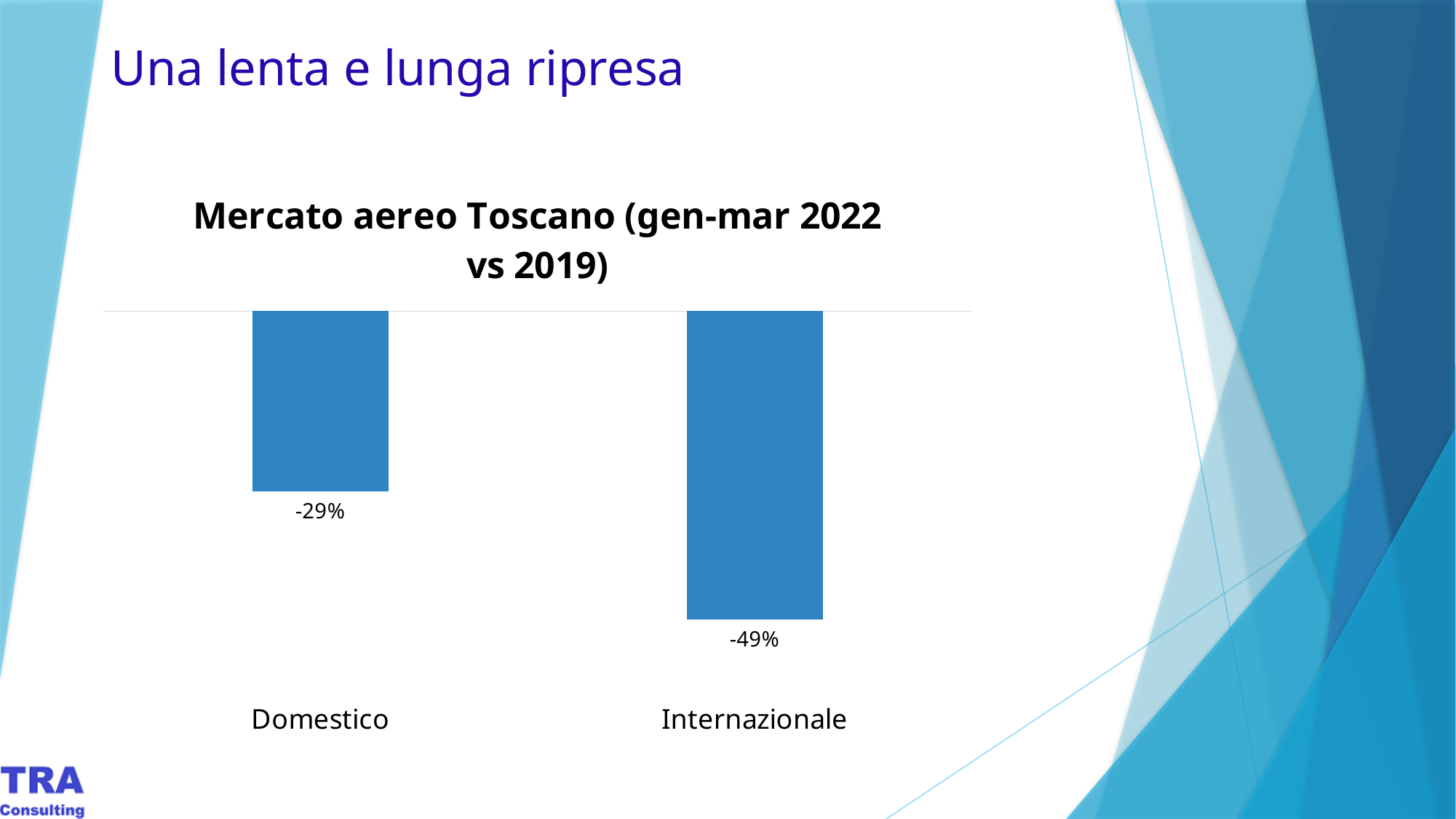
Are the values in the chart positive or negative? Negative What kind of chart is shown on the slide? Bar chart Which category has the lowest value? Internazionale How many categories are shown in the chart? 2 Which category has the highest value? Domestico What is the difference between the values for Domestico and Internazionale? 20 percentage points What is the value for Domestico? -29% What is the title of the chart? Mercato aereo Toscano (gen-mar 2022 vs 2019) What is the value for Internazionale? -49% Which is larger, the value for Domestico or the value for Internazionale? Domestico